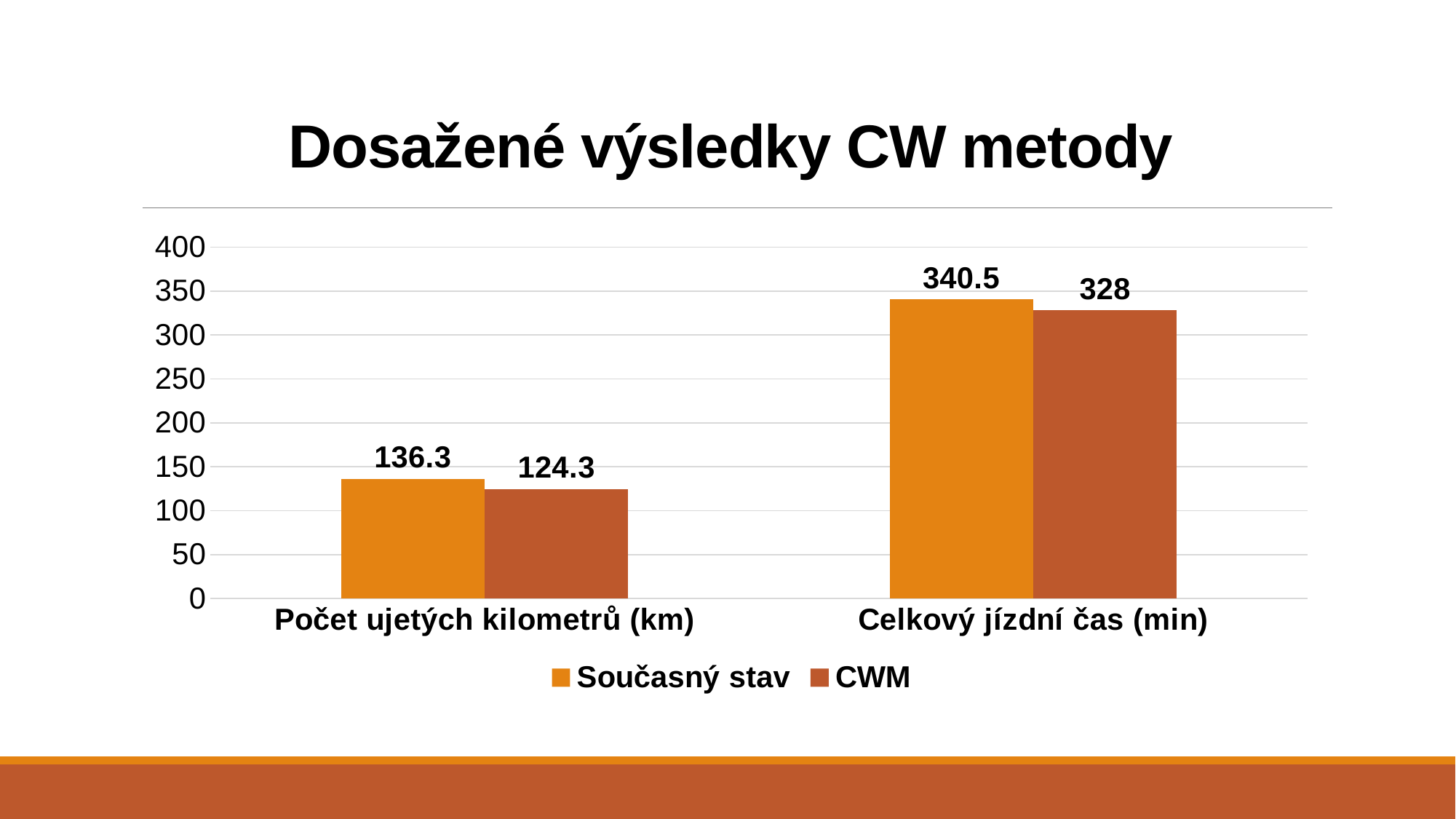
What is the difference between Současný stav and CWM for Celkový jízdní čas (min)? 12.5 Which bar is the lowest in the chart? CWM for Počet ujetých kilometrů (km) What is the value of Současný stav for Celkový jízdní čas (min)? 340.5 What is the value of Současný stav for Počet ujetých kilometrů (km)? 136.3 What type of chart is shown on the slide? Bar chart What is the value of CWM for Celkový jízdní čas (min)? 328 Which bar is the highest in the chart? Současný stav for Celkový jízdní čas (min) Which series has the larger value for Celkový jízdní čas (min), Současný stav or CWM? Současný stav How many series does the legend list? 2 How many categories are shown on the x axis? 2 What is the difference between Současný stav and CWM for Počet ujetých kilometrů (km)? 12 What is the value of CWM for Počet ujetých kilometrů (km)? 124.3